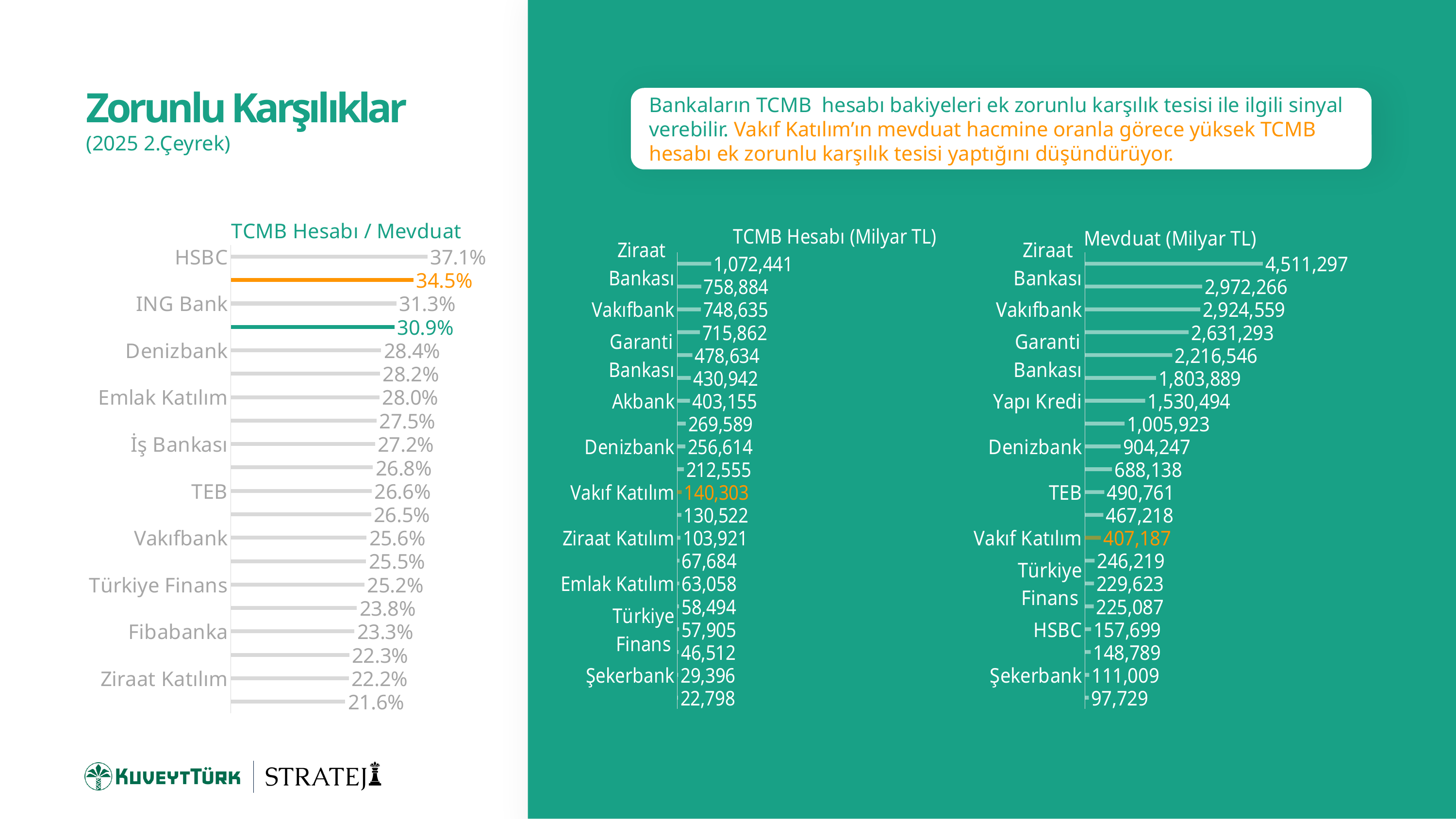
What kind of chart is the 'TCMB Hesabı / Mevduat' chart on the left? Bar chart How many bars are plotted in the 'TCMB Hesabı / Mevduat' chart? 20 In the 'Mevduat (Milyar TL)' chart, what is the value for Vakıf Katılım? 407,187 In the 'TCMB Hesabı / Mevduat' chart, what is the value for HSBC? 37.1% In the 'TCMB Hesabı (Milyar TL)' chart, what is the value for Şekerbank? 29,396 In the 'TCMB Hesabı / Mevduat' chart, what is the difference between HSBC (37.1%) and ING Bank (31.3%)? 5.8% In the 'TCMB Hesabı (Milyar TL)' chart, what is the value for Vakıf Katılım? 140,303 In the 'Mevduat (Milyar TL)' chart, which is larger, the value for TEB or the value for HSBC? TEB In the 'TCMB Hesabı (Milyar TL)' chart, what is the largest value shown? 1,072,441 In the 'TCMB Hesabı / Mevduat' chart, what is the value for Ziraat Katılım? 22.2% In the 'Mevduat (Milyar TL)' chart, what is the value for Yapı Kredi? 1,530,494 In the 'TCMB Hesabı / Mevduat' chart, which labeled bank has the highest ratio? HSBC